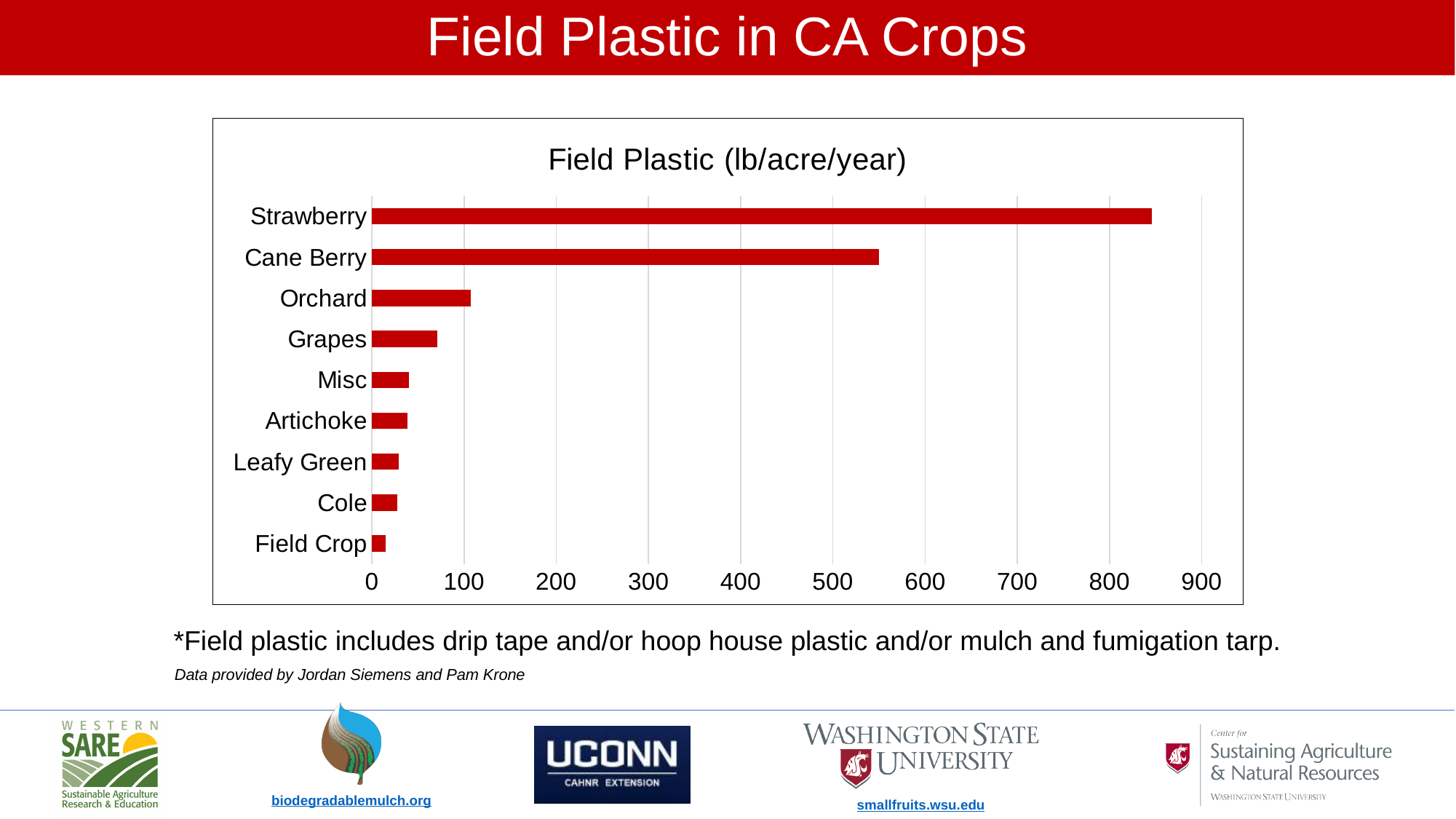
Which has a larger field plastic value, Orchard or Grapes? Orchard Is the value for Strawberry greater or less than 800? greater Is the value for Grapes greater or less than 100? less What colour are the bars in the chart? red Is the value for Cane Berry greater or less than 600? less Which crop has the lowest field plastic value? Field Crop What kind of chart is shown on the slide? bar chart Which crop has the highest field plastic value? Strawberry What is the title of the chart? Field Plastic (lb/acre/year) How many crop categories are shown in the chart? 9 Which has a larger field plastic value, Strawberry or Cane Berry? Strawberry